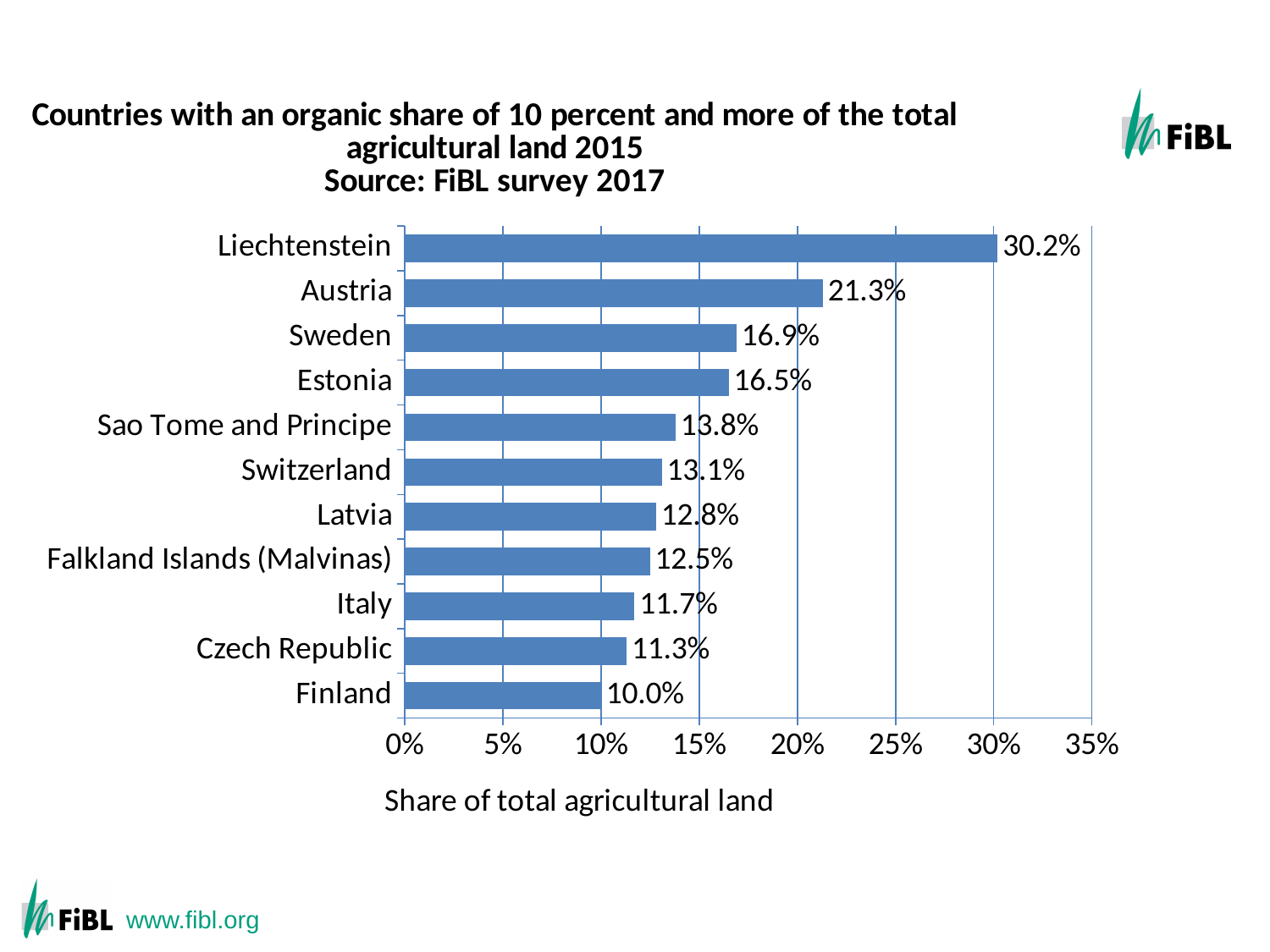
What is the organic share of total agricultural land for Austria? 21.3% What is the organic share of total agricultural land for Czech Republic? 11.3% Which country has the highest organic share of total agricultural land? Liechtenstein Is the value for Italy greater or less than 15%? less What is the organic share of total agricultural land for Sao Tome and Principe? 13.8% What kind of chart is shown on the slide? Bar chart Which country has the lowest organic share of total agricultural land? Finland Which has a larger organic share of agricultural land, Switzerland or Latvia? Switzerland What is the difference in organic share between Liechtenstein and Austria? 8.9% How many countries are shown in the chart? 11 What is the label of the horizontal axis? Share of total agricultural land What is the difference in organic share between Sweden and Estonia? 0.4%